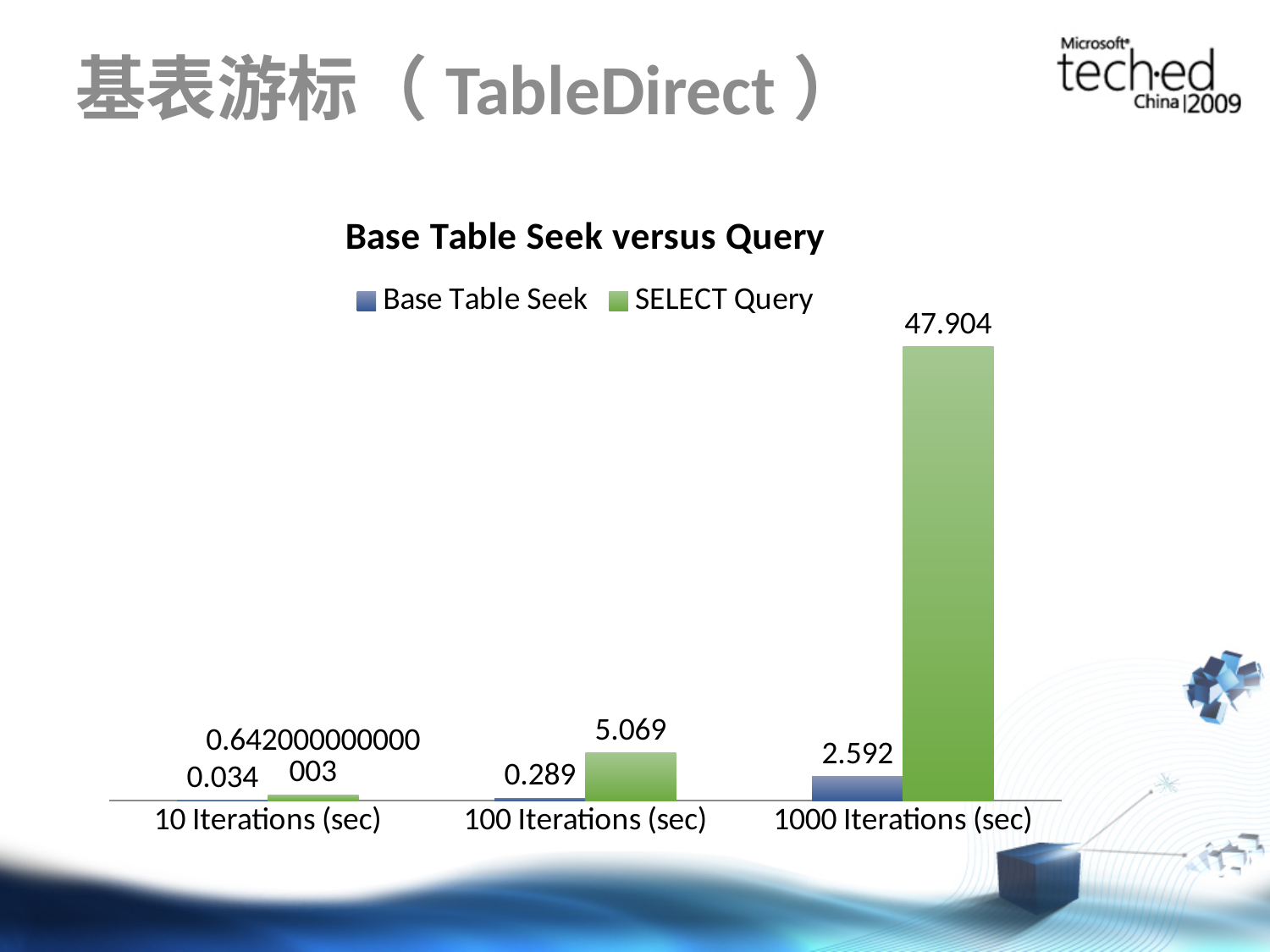
Do the Base Table Seek values rise or fall from 10 Iterations to 1000 Iterations? Rise What is the difference between the SELECT Query and Base Table Seek values for 1000 Iterations (sec)? 45.312 What is the Base Table Seek value for 1000 Iterations (sec)? 2.592 How many series does the legend list? 2 Which category has the lowest Base Table Seek value? 10 Iterations (sec) What is the title of the chart? Base Table Seek versus Query Which category has the highest SELECT Query value? 1000 Iterations (sec) What is the SELECT Query value for 1000 Iterations (sec)? 47.904 What type of chart is shown on the slide? Bar chart What is the SELECT Query value for 100 Iterations (sec)? 5.069 What is the Base Table Seek value for 10 Iterations (sec)? 0.034 How many categories are shown on the x axis? 3